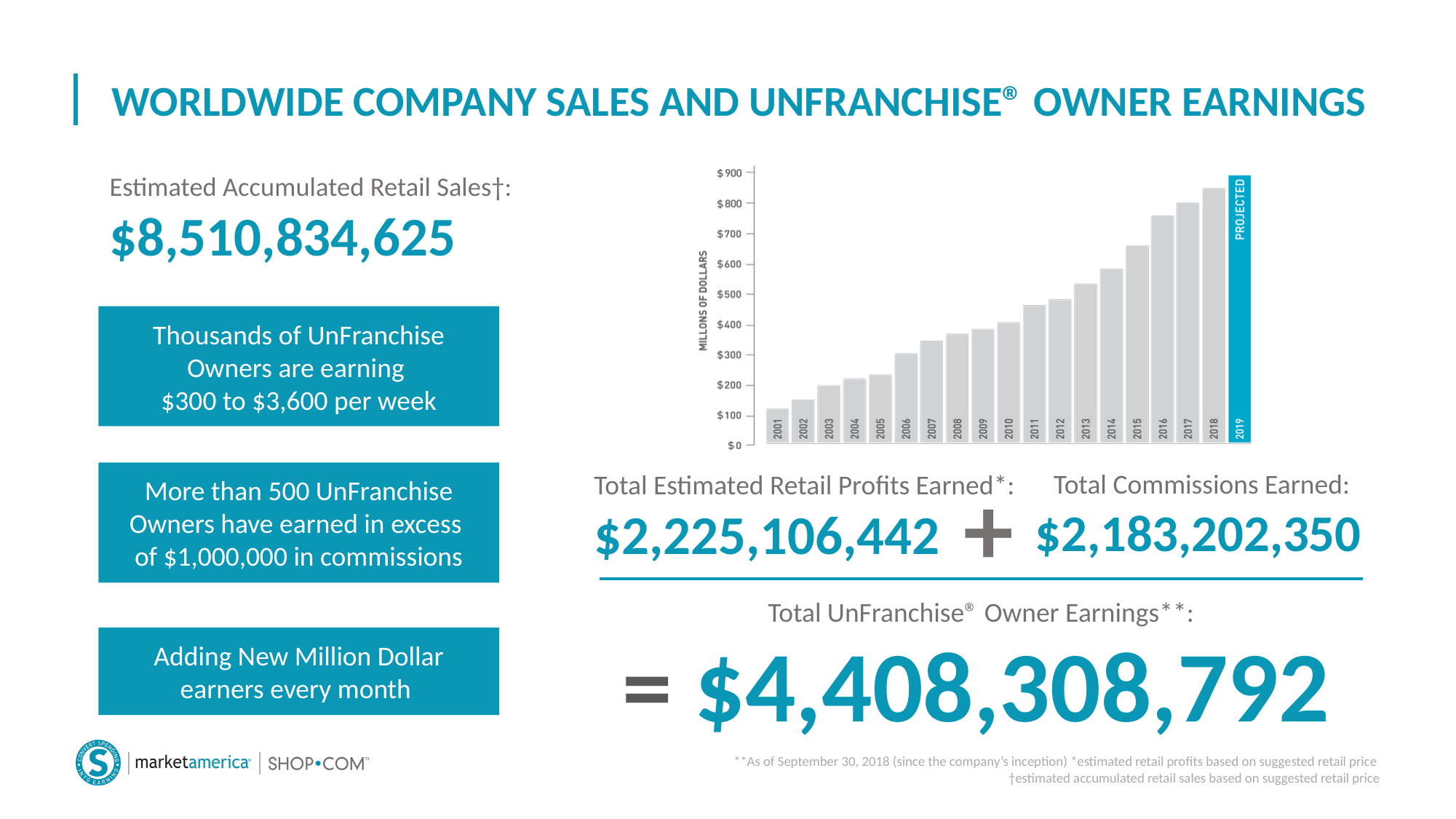
Is the value for 2010 greater or less than $500? less What is the label on the vertical axis of the chart? MILLIONS OF DOLLARS Which year has the tallest bar on the chart? 2019 Is the value for 2018 greater or less than $800? greater Which year has the shortest bar on the chart? 2001 Is the value for 2001 greater or less than $200? less What kind of chart is shown on the slide? bar chart Which year's bar is marked as projected on the chart? 2019 Which year has the larger bar, 2008 or 2012? 2012 Do the bar values rise or fall from 2001 to 2019? rise How many years are plotted on the bar chart? 19